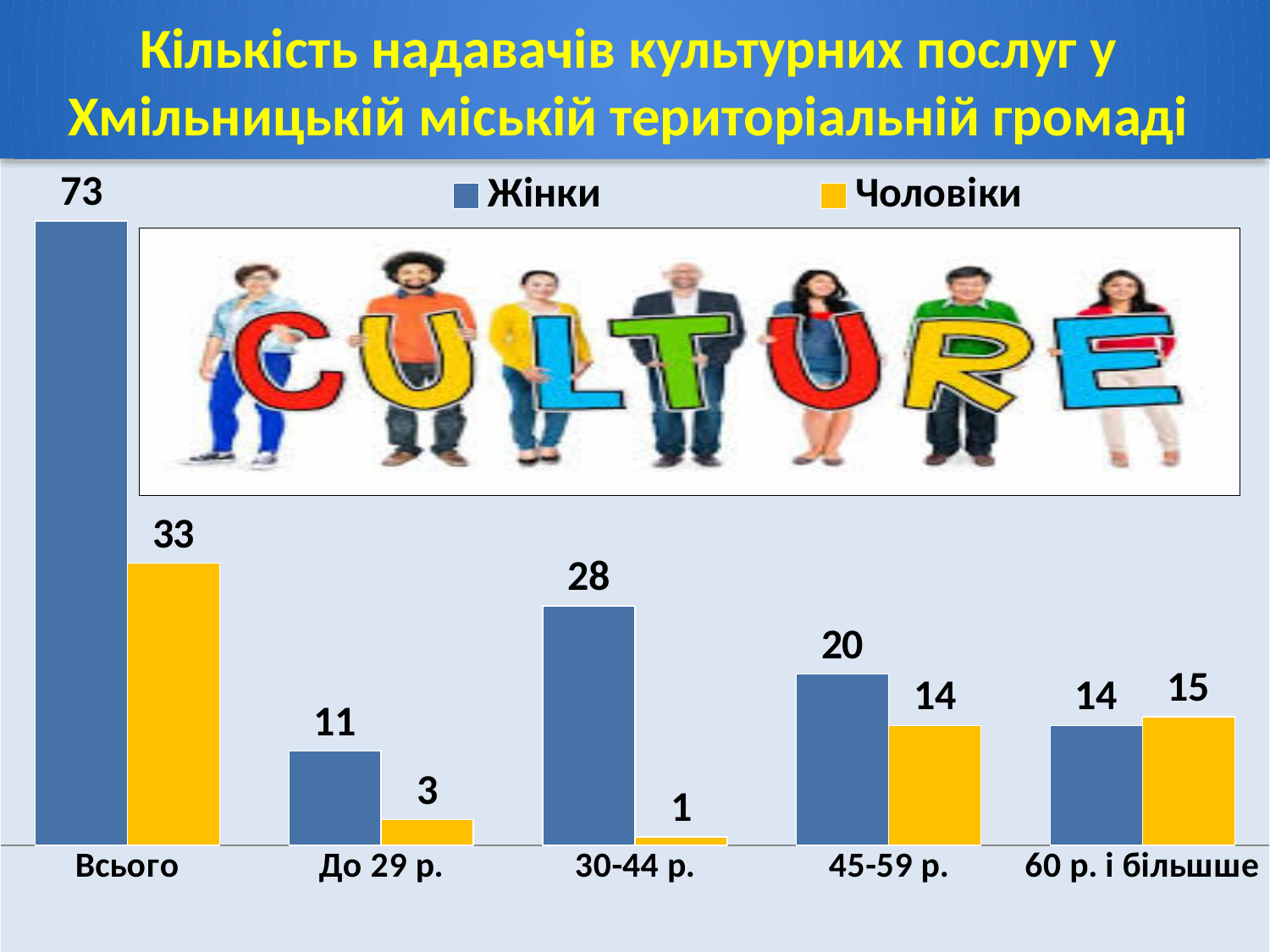
How many series does the legend list? 2 Among the age groups (excluding Всього), which category has the highest value for Жінки? 30-44 р. Which colour represents the Чоловіки series? Yellow Which category has the lowest value for Чоловіки? 30-44 р. What is the value for Чоловіки in the До 29 р. category? 3 What is the difference between the Жінки and Чоловіки values in the Всього category? 40 What is the value for Жінки in the Всього category? 73 What kind of chart is shown on the slide? Bar chart How many categories are shown on the x axis? 5 In the 60 р. і більшше category, which series has the larger value, Жінки or Чоловіки? Чоловіки What is the value for Чоловіки in the 30-44 р. category? 1 What is the value for Жінки in the 45-59 р. category? 20